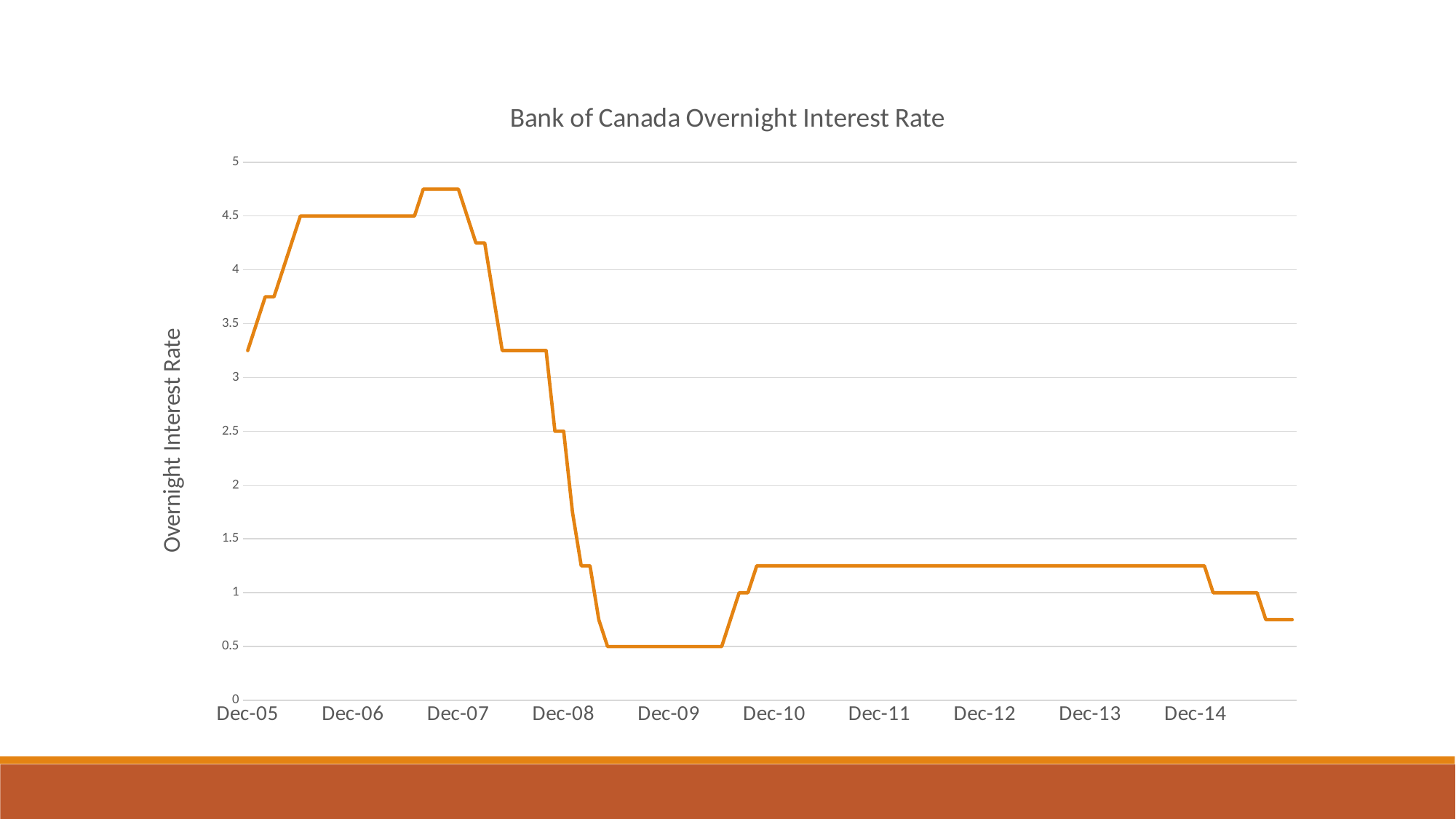
Is the value at Dec-12 greater or less than 1.5? less What kind of chart is shown on the slide? line chart Of the labelled dates on the x axis, which has the lowest interest rate? Dec-09 Does the interest rate rise or fall between Dec-07 and Dec-09? fall What is the overnight interest rate at Dec-06? 4.5 What is the difference between the interest rate at Dec-06 and at Dec-09? 4 Is the value at Dec-07 greater or less than 4.5? greater Which of the labelled dates, Dec-06 or Dec-09, has the higher interest rate? Dec-06 What is the overnight interest rate at Dec-09? 0.5 What is the title of the chart? Bank of Canada Overnight Interest Rate Is the value at Dec-05 greater or less than 3? greater What is the label on the vertical axis? Overnight Interest Rate